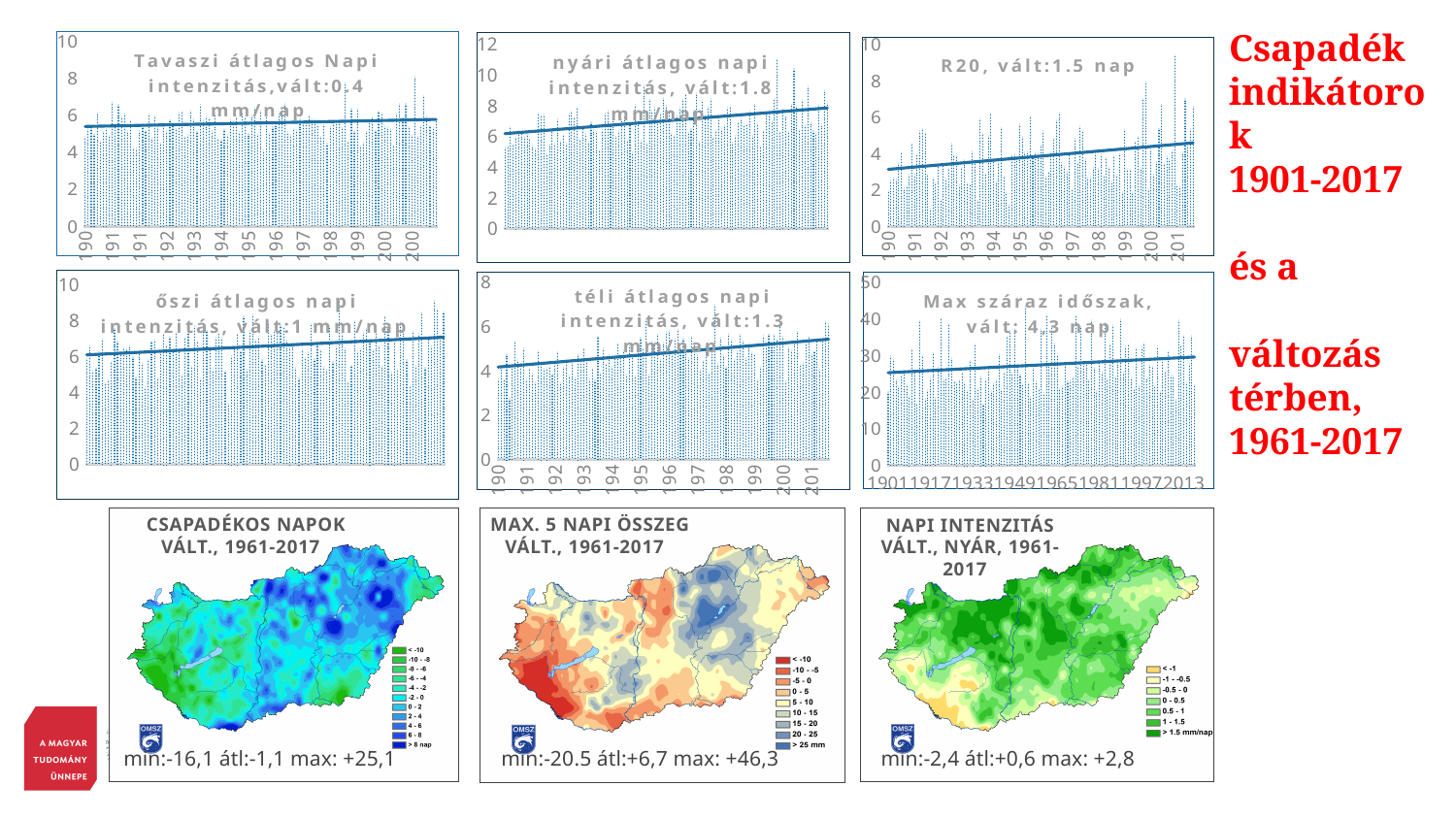
According to the title of the 'nyári átlagos napi intenzitás' chart, what is the change (vált) value? 1.8 mm/nap In the chart titled 'Tavaszi átlagos Napi intenzitás', does the trend line rise or fall from left to right? rise According to the title of the 'R20' chart, what is the change (vált) value? 1.5 nap According to the title of the 'Max száraz időszak' chart, what is the change (vált) value? 4,3 nap What kind of chart is the 'téli átlagos napi intenzitás' chart? bar chart with a trend line What is the highest value shown on the y axis of the 'nyári átlagos napi intenzitás' chart? 12 On the 'Napi intenzitás vált., nyár, 1961-2017' map, what is the átl (average) value printed below it? +0,6 On the 'Csapadékos napok vált., 1961-2017' map, what is the max value printed below it? +25,1 In the chart titled 'Max száraz időszak', does the trend line rise or fall over time? rise Which map shows the larger max value: 'Csapadékos napok' or 'Max. 5 napi összeg'? Max. 5 napi összeg How many time-series charts with trend lines are shown in the top two rows of the slide? 6 On the 'Max. 5 napi összeg vált., 1961-2017' map, what is the min value printed below it? -20.5